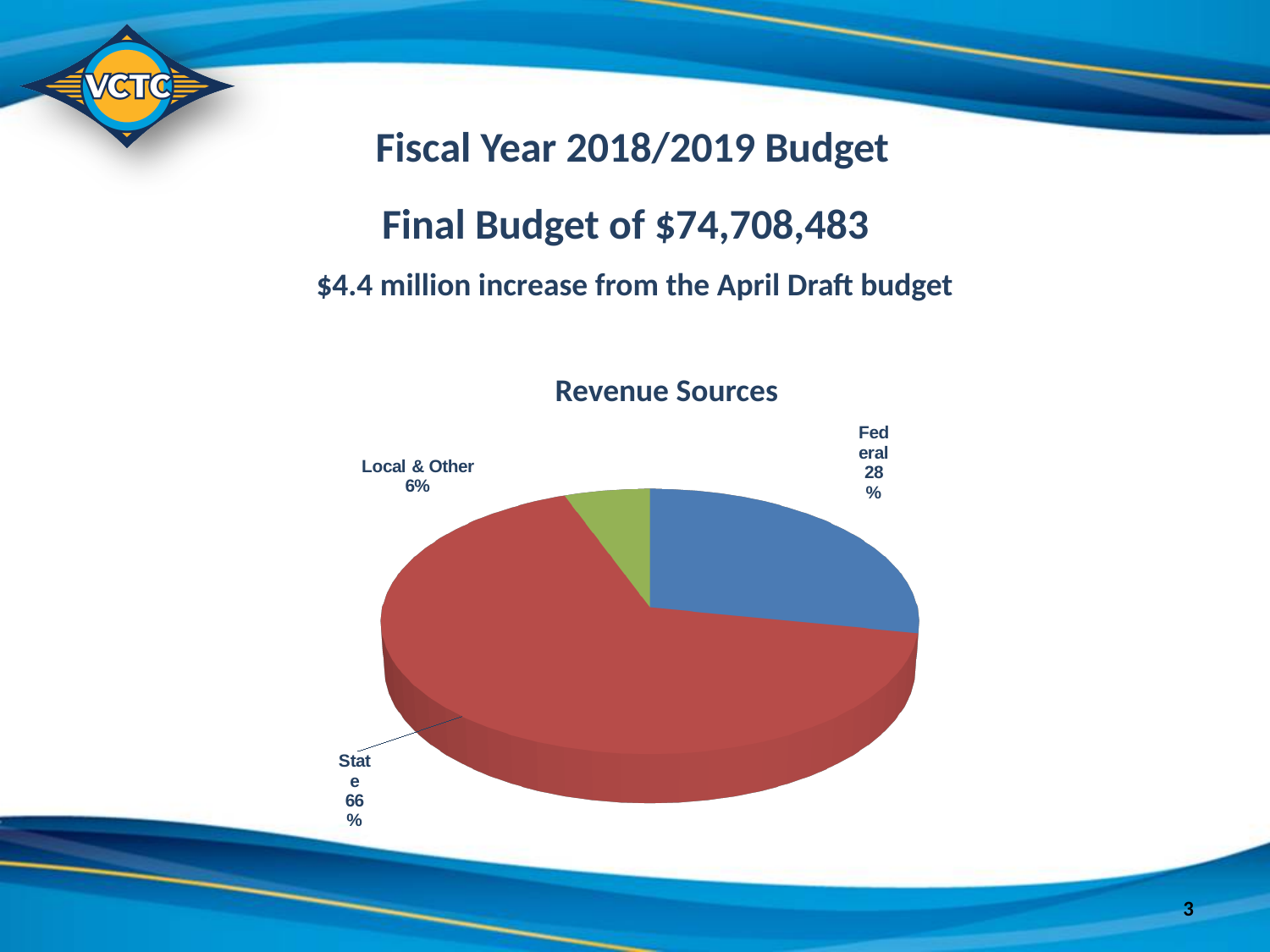
What share of revenue comes from State sources? 66% What is the title of the pie chart? Revenue Sources What colour is the State slice of the pie chart? red What is the difference in percentage points between the State share and the Federal share? 38 Which is larger, the Federal share or the Local & Other share? Federal Which revenue source has the largest share of the pie? State Which revenue source has the smallest share of the pie? Local & Other What share of revenue comes from Federal sources? 28% What type of chart is shown under the title "Revenue Sources"? pie chart How many slices does the Revenue Sources pie chart have? 3 What share of revenue comes from Local & Other sources? 6% What is the difference in percentage points between the Federal share and the Local & Other share? 22